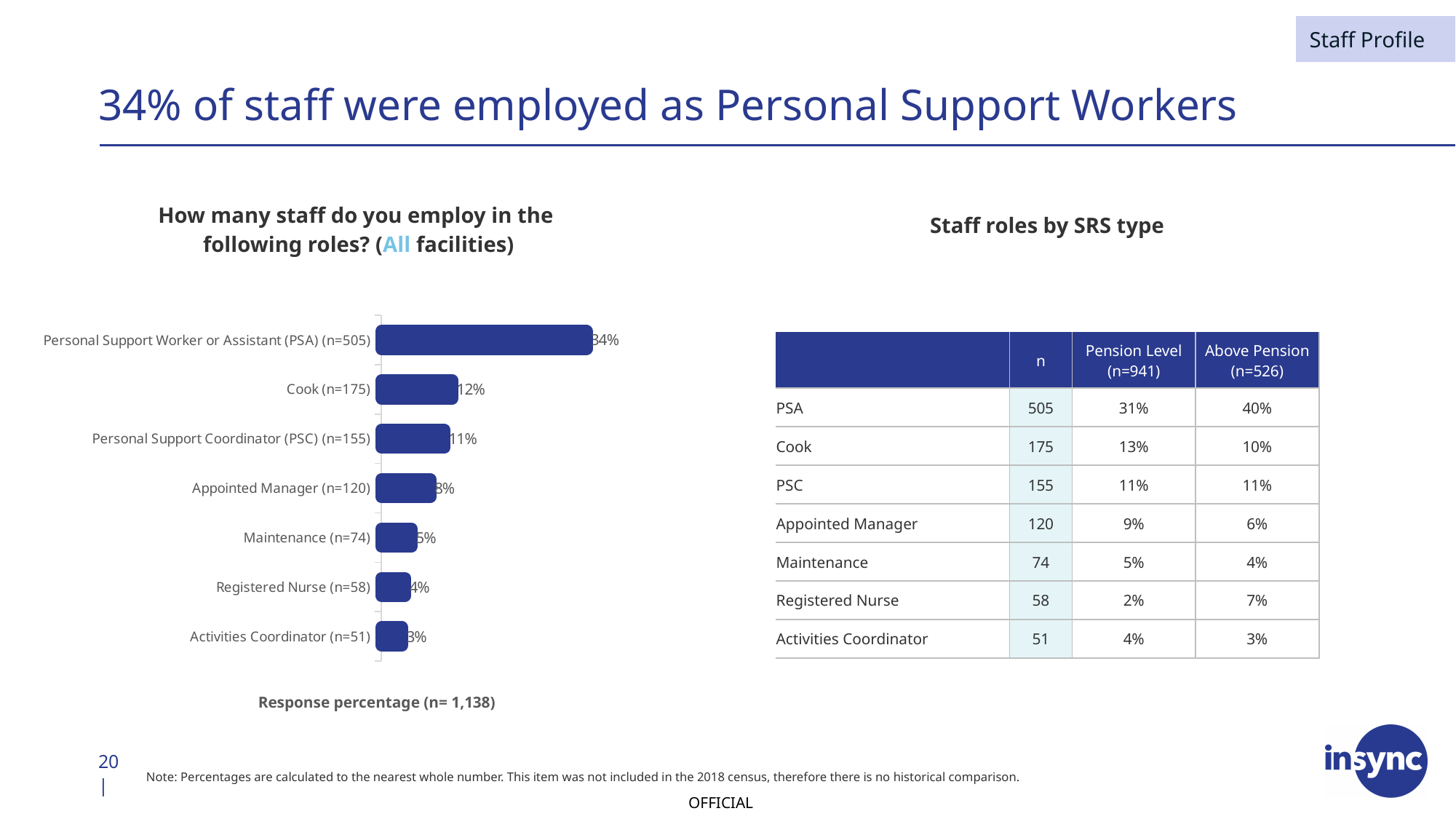
How many roles are shown in the bar chart? 7 What is the value for Registered Nurse in the bar chart? 4% Which is larger in the bar chart, the value for Cook or the value for Maintenance? Cook What is the value for Personal Support Coordinator (PSC) in the bar chart? 11% What kind of chart is used to show the staff roles? Bar chart What is the value for Personal Support Worker or Assistant (PSA) in the bar chart? 34% What is the value for Cook in the bar chart? 12% Which role has the highest value in the bar chart? Personal Support Worker or Assistant (PSA) Which role has the lowest value in the bar chart? Activities Coordinator What is the title of the bar chart? How many staff do you employ in the following roles? (All facilities) What is the difference between the values for Personal Support Worker or Assistant (PSA) and Cook in the bar chart? 22% What is the value for Maintenance in the bar chart? 5%